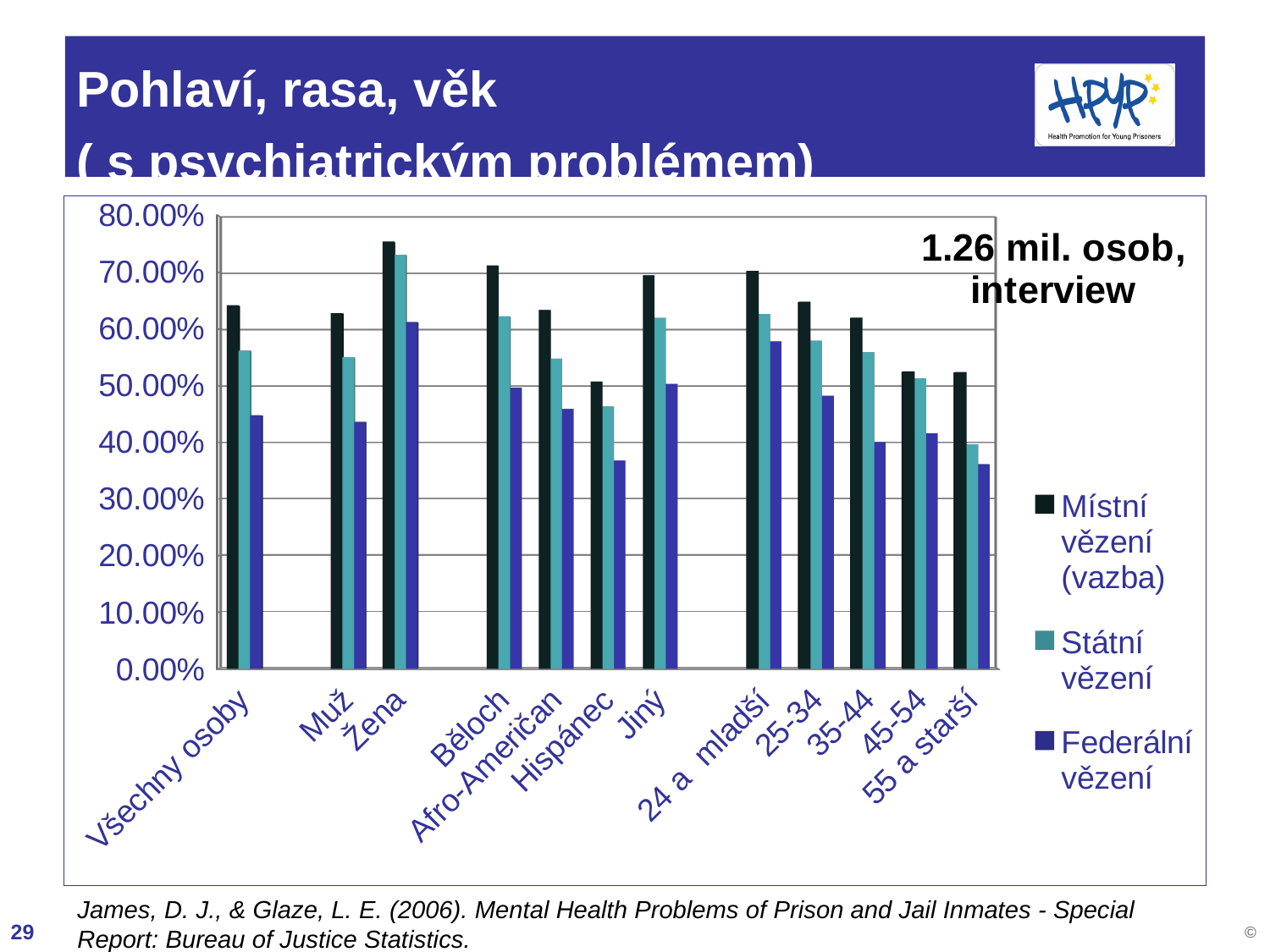
Which is larger for Místní vězení (vazba): Muž or Žena? Žena Which category has the lowest value for Státní vězení? 55 a starší Is the Státní vězení value for Všechny osoby greater or less than 50.00%? greater Is the Federální vězení value for Hispánec greater or less than 40.00%? less Which category has the highest value for Místní vězení (vazba)? Žena Which is larger for Federální vězení: 24 a mladší or 55 a starší? 24 a mladší Do the Místní vězení (vazba) values rise or fall across the age groups from 24 a mladší to 55 a starší? fall How many series does the legend list? 3 Is the Místní vězení (vazba) value for Žena greater or less than 70.00%? greater Which category has the highest value for Státní vězení? Žena How many categories are shown on the x axis? 12 What kind of chart is shown on the slide? bar chart